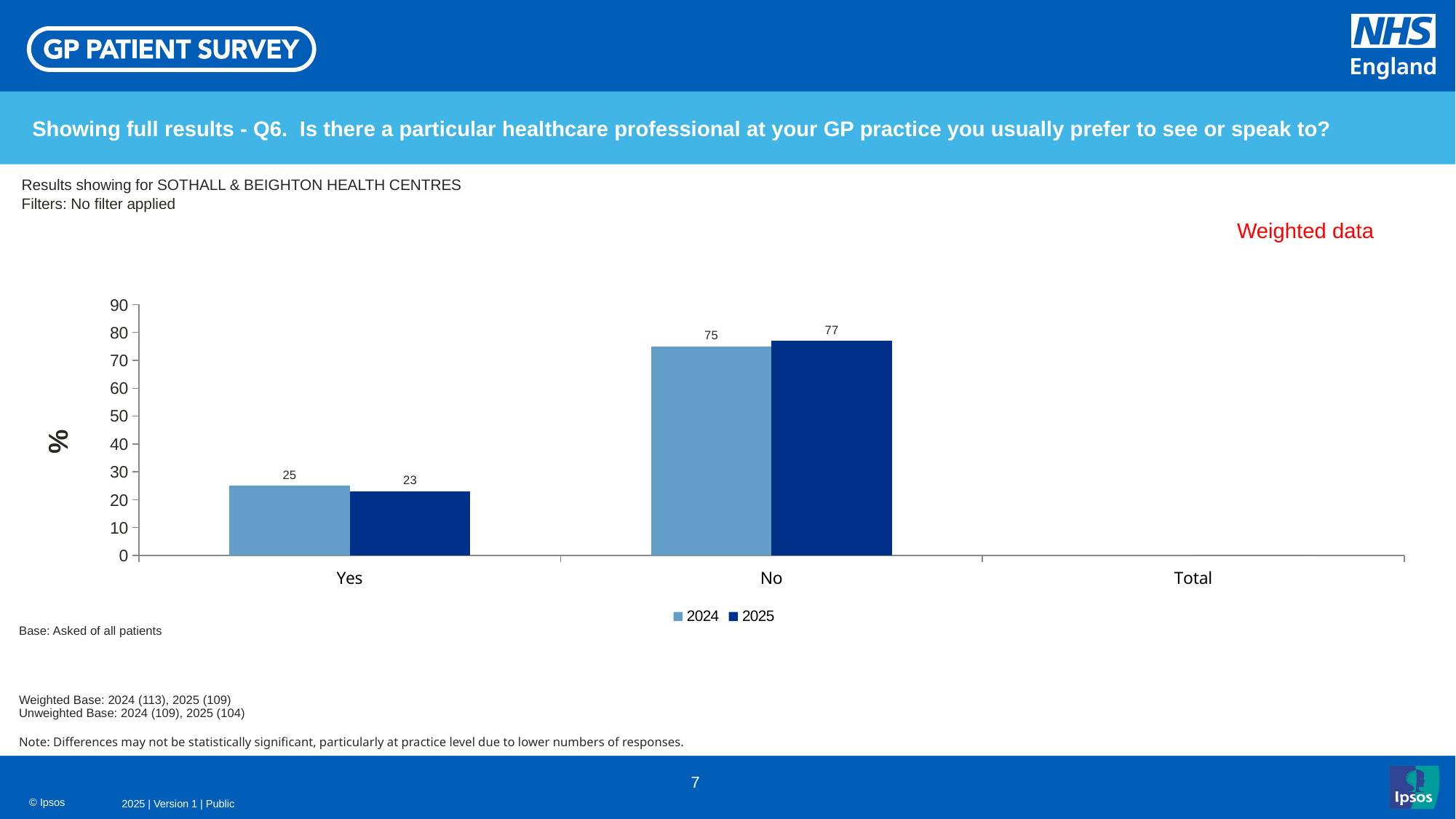
Which category has the highest value in the 2025 series? No What is the value for 'No' in the 2024 series? 75 Which is larger for 'Yes': the 2024 value or the 2025 value? 2024 What is the value for 'Yes' in the 2025 series? 23 What is the difference between the 2024 and 2025 values for 'Yes'? 2 What is the difference between the 2025 and 2024 values for 'No'? 2 What is the value for 'Yes' in the 2024 series? 25 What is the value for 'No' in the 2025 series? 77 What kind of chart is shown on the slide? Bar chart Which category has the lowest value in the 2024 series? Yes What label is shown on the vertical axis of the chart? % How many series does the legend list? 2